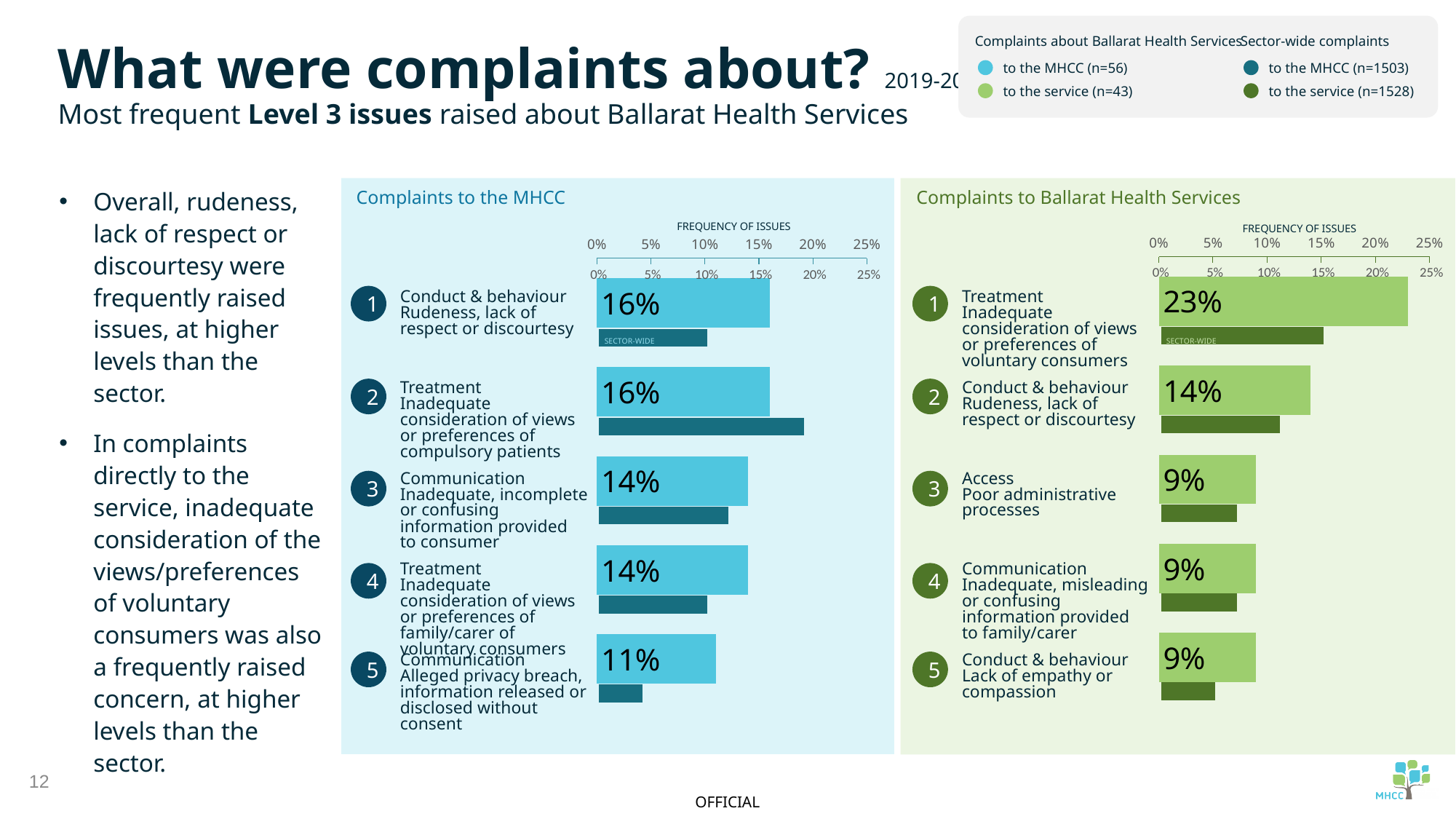
In the 'Complaints to the MHCC' chart, which issue has the lowest frequency? Communication – Alleged privacy breach, information released or disclosed without consent In the 'Complaints to Ballarat Health Services' chart, what is the difference in frequency between the top issue (23%) and the second issue (14%)? 9 percentage points What type of chart is used in the 'Complaints to the MHCC' panel? Bar chart In the 'Complaints to the MHCC' chart, what is the frequency of issues for 'Conduct & behaviour – Rudeness, lack of respect or discourtesy'? 16% How many issues are listed in the 'Complaints to Ballarat Health Services' chart? 5 In the 'Complaints to the MHCC' chart, what is the frequency of issues for 'Communication – Alleged privacy breach, information released or disclosed without consent'? 11% In the 'Complaints to Ballarat Health Services' chart, which issue has the highest frequency? Treatment – Inadequate consideration of views or preferences of voluntary consumers Which is larger: the frequency of 'Conduct & behaviour – Rudeness, lack of respect or discourtesy' in the 'Complaints to the MHCC' chart or in the 'Complaints to Ballarat Health Services' chart? Complaints to the MHCC (16%) In the 'Complaints to the MHCC' chart, is the sector-wide bar for 'Treatment – Inadequate consideration of views or preferences of compulsory patients' greater or less than 15%? greater In the 'Complaints to the MHCC' chart, what is the difference between the frequency for 'Conduct & behaviour – Rudeness, lack of respect or discourtesy' and 'Communication – Alleged privacy breach'? 5 percentage points In the 'Complaints to Ballarat Health Services' chart, what is the frequency of issues for 'Conduct & behaviour – Rudeness, lack of respect or discourtesy'? 14% In the 'Complaints to Ballarat Health Services' chart, what is the frequency of issues for 'Treatment – Inadequate consideration of views or preferences of voluntary consumers'? 23%